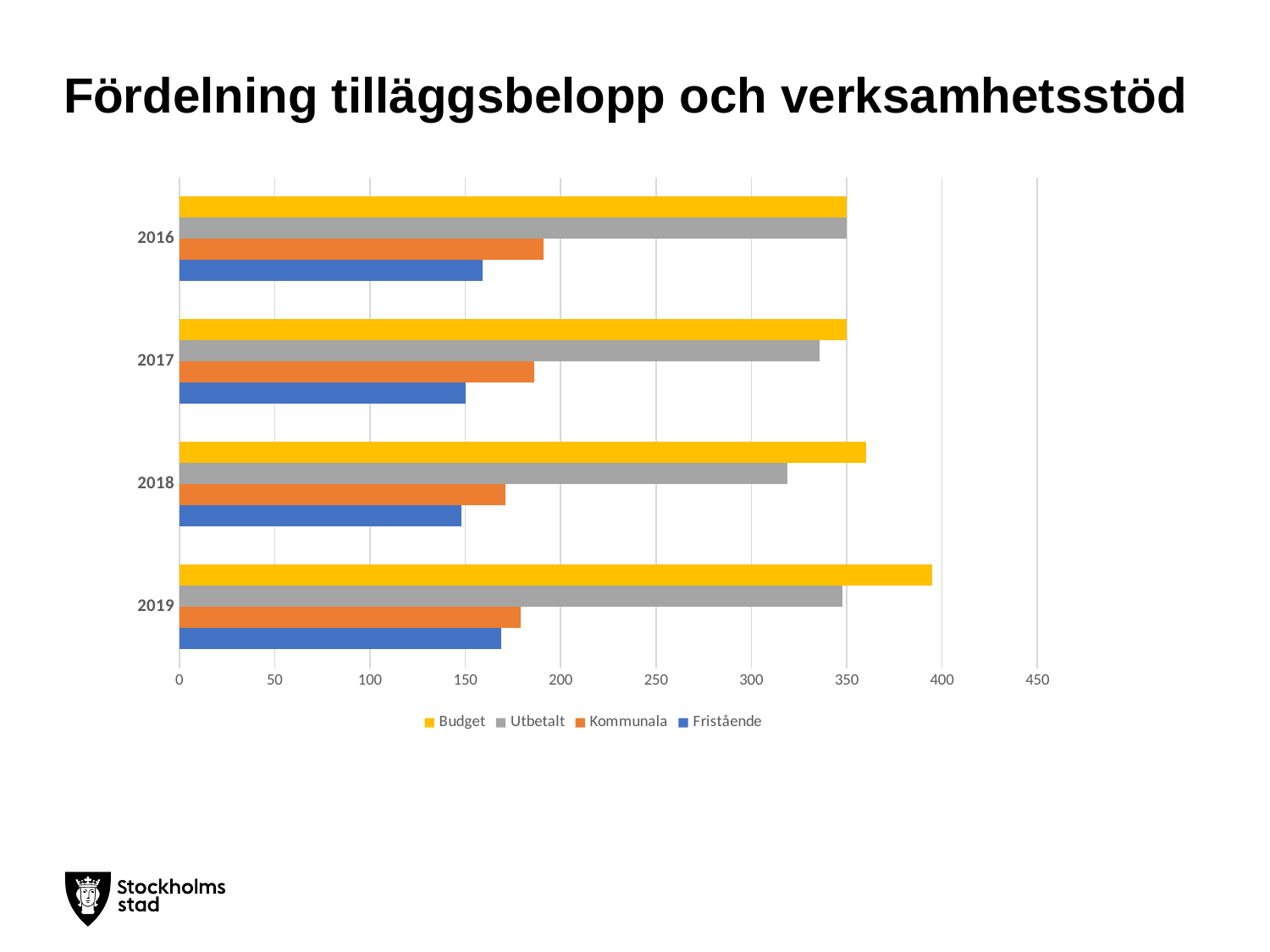
Is the Fristående value for 2017 greater or less than 200? less Which is larger in 2018, the Budget bar or the Utbetalt bar? Budget Which colour represents the Utbetalt series in the legend? grey Which series has the shortest bar in 2018? Fristående How many years are shown on the vertical axis? 4 Which is larger in 2017, the Kommunala bar or the Fristående bar? Kommunala Which series has the longest bar in 2019? Budget What kind of chart is shown on the slide? bar chart What is the title of the slide? Fördelning tilläggsbelopp och verksamhetsstöd Is the Utbetalt value for 2018 greater or less than 300? greater Is the Budget value for 2019 greater or less than 350? greater How many series does the legend list? 4